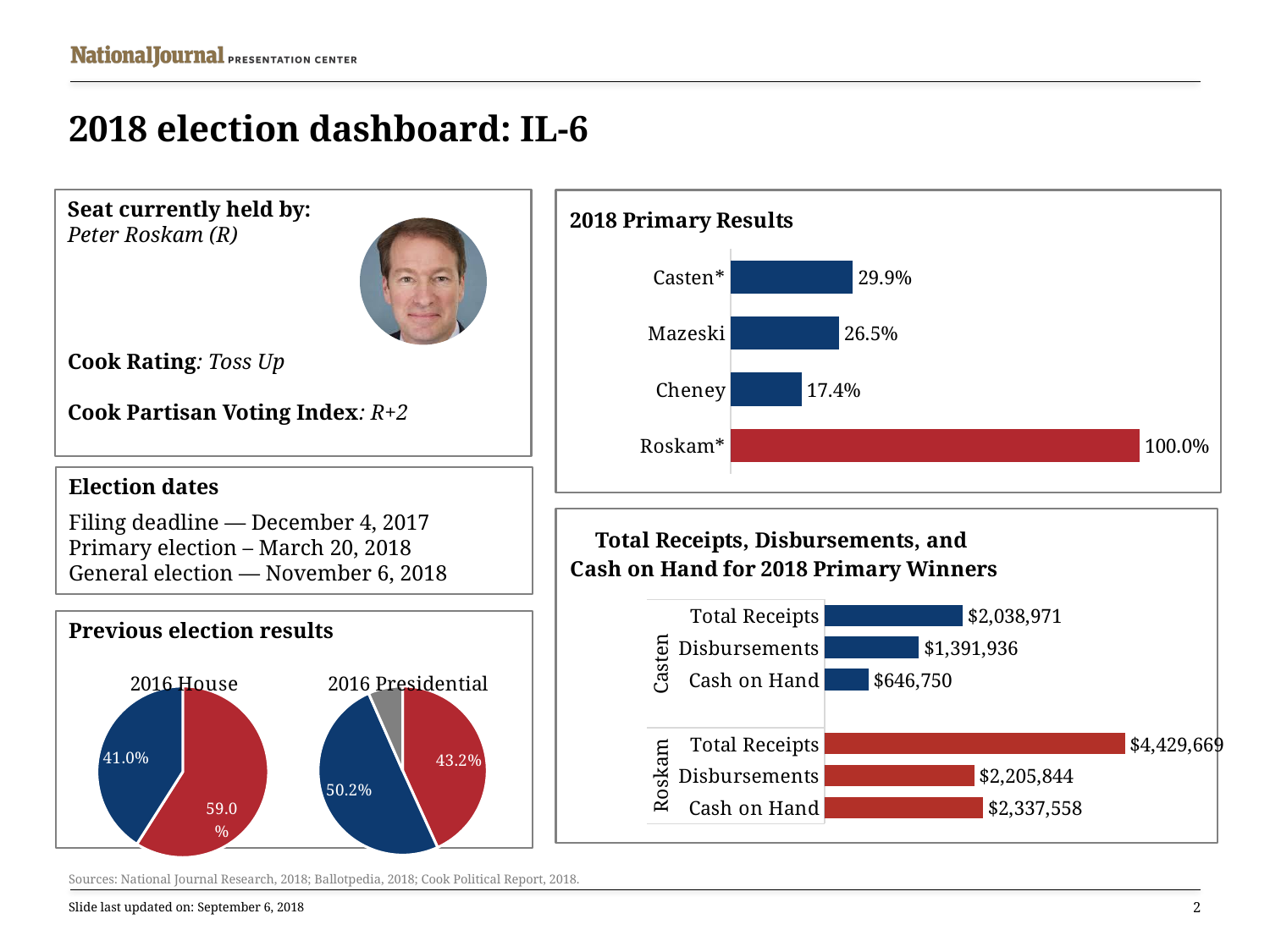
What type of chart is the 2018 Primary Results chart? Bar chart In the 2018 Primary Results chart, what is the difference in percentage points between Casten* and Mazeski? 3.4 In the Total Receipts, Disbursements, and Cash on Hand chart, what is the difference between Roskam's and Casten's Total Receipts? $2,390,698 In the Total Receipts, Disbursements, and Cash on Hand chart, which is larger: Roskam's Disbursements or Roskam's Cash on Hand? Roskam's Cash on Hand In the Total Receipts, Disbursements, and Cash on Hand chart, what is Casten's Cash on Hand? $646,750 In the 2018 Primary Results chart, what percentage did Cheney receive? 17.4% In the 2018 Primary Results chart, which candidate has the highest percentage? Roskam* In the 2016 Presidential pie chart, what is the value of the blue slice? 50.2% In the 2018 Primary Results chart, what percentage did Casten* receive? 29.9% In the 2018 Primary Results chart, which candidate has the lowest percentage? Cheney How many candidates are shown in the 2018 Primary Results chart? 4 In the 2016 House pie chart, what is the value of the red slice? 59.0%